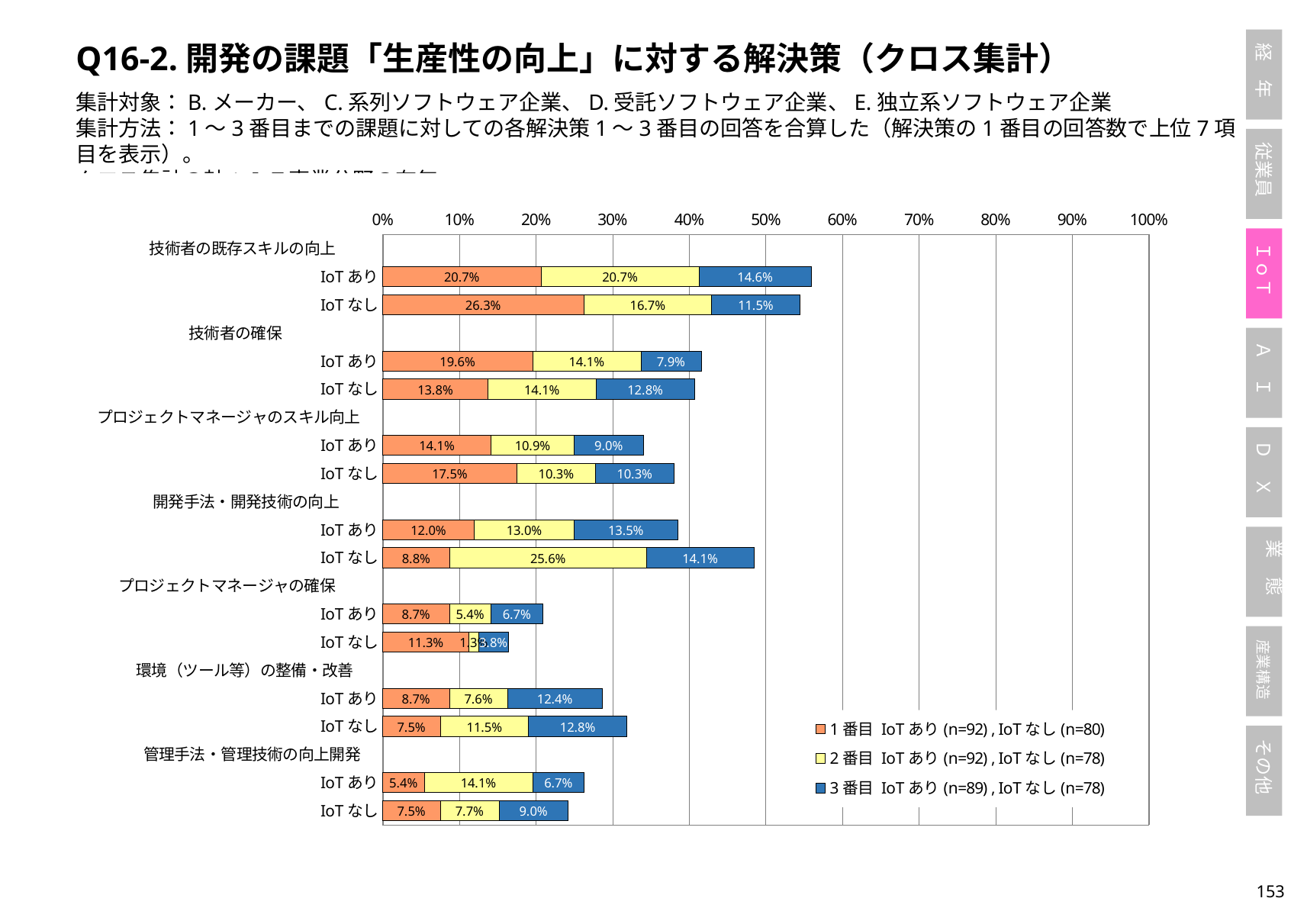
Which solution category has the longest stacked bar overall? 技術者の既存スキルの向上 (IoT あり) What is the total of the stacked bar for 技術者の既存スキルの向上, IoT あり? 56.0% What is the difference between the 1番目 values for 技術者の確保 IoT あり and IoT なし? 5.8% Which is larger: the 3番目 value for 技術者の確保 IoT あり or IoT なし? IoT なし How many solution categories are shown on the chart? 7 How many series does the legend list? 3 What is the 1番目 value for 管理手法・管理技術の向上開発, IoT あり? 5.4% What is the 2番目 value for 開発手法・開発技術の向上, IoT なし? 25.6% What kind of chart is shown on the slide? Stacked bar chart What is the 3番目 value for 環境（ツール等）の整備・改善, IoT あり? 12.4% What is the 1番目 value for 技術者の既存スキルの向上, IoT なし? 26.3% Is the total stacked bar for プロジェクトマネージャの確保, IoT なし greater or less than 20%? less